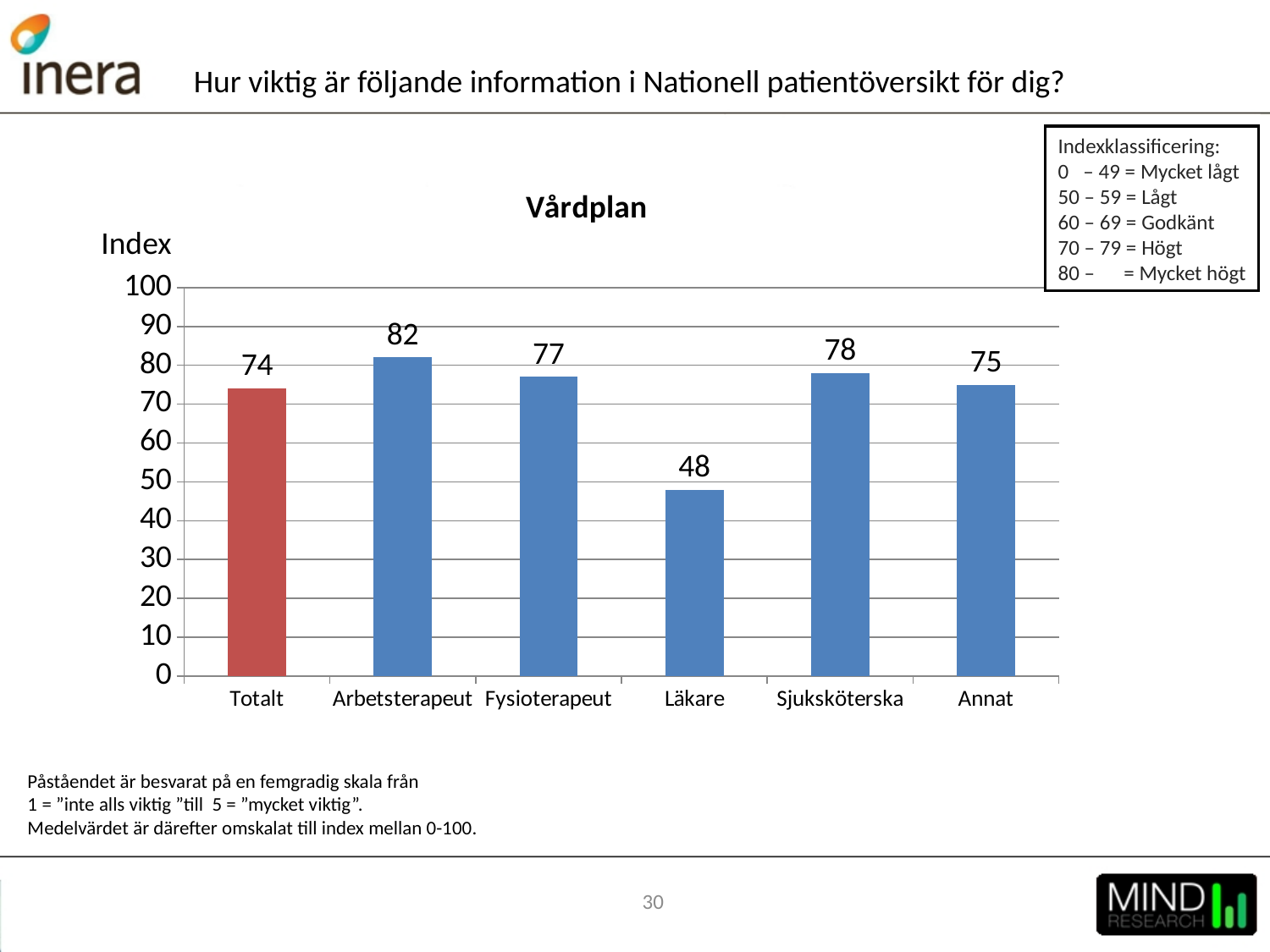
Is the value for Läkare greater or less than 50? less What is the index value for Totalt? 74 What is the index value for Sjuksköterska? 78 What kind of chart is shown on the slide? bar chart Which category has the highest index value? Arbetsterapeut What is the difference between the index values for Arbetsterapeut and Läkare? 34 What is the title of the chart? Vårdplan How many categories are shown on the x axis? 6 Which has a higher index value, Fysioterapeut or Annat? Fysioterapeut What is the index value for Läkare? 48 Which category has the lowest index value? Läkare What is the index value for Arbetsterapeut? 82